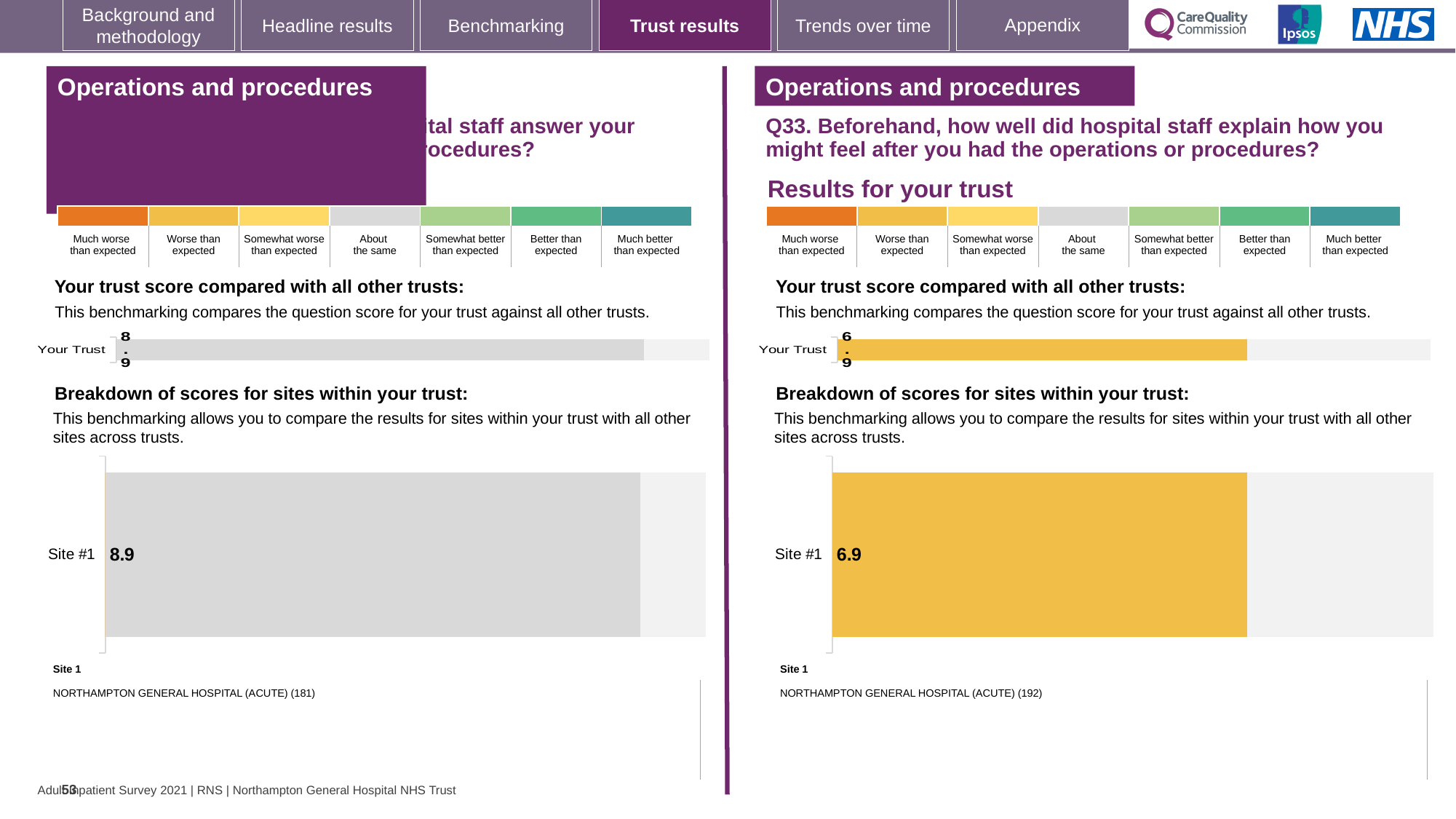
On the right half of the slide (Q33), which benchmark category does the yellow colour of the Site #1 bar correspond to in the key? Worse than expected How many sites are shown in the 'Breakdown of scores for sites within your trust' chart on the right half of the slide (Q33)? 1 What is the difference between the Your Trust score on the left half of the slide and the Your Trust score on the right half (Q33)? 2.0 What type of chart is used to show the Your Trust score on the right half of the slide (Q33)? Bar chart Which is larger: the Site #1 score on the left half of the slide or the Site #1 score on the right half (Q33)? Left half (8.9) On the right half of the slide (Q33), what is the score shown for Your Trust in the 'Your trust score compared with all other trusts' chart? 6.9 On the left half of the slide, what is the score for Site #1 in the 'Breakdown of scores for sites within your trust' chart? 8.9 How many sites are shown in the 'Breakdown of scores for sites within your trust' chart on the left half of the slide? 1 On the right half of the slide (Q33), what is the score for Site #1 in the 'Breakdown of scores for sites within your trust' chart? 6.9 On the left half of the slide, what is the score shown for Your Trust in the 'Your trust score compared with all other trusts' chart? 8.9 On the left half of the slide, which benchmark category does the grey colour of the Site #1 bar correspond to in the key? About the same What type of chart is used to show the Site #1 score on the left half of the slide? Bar chart